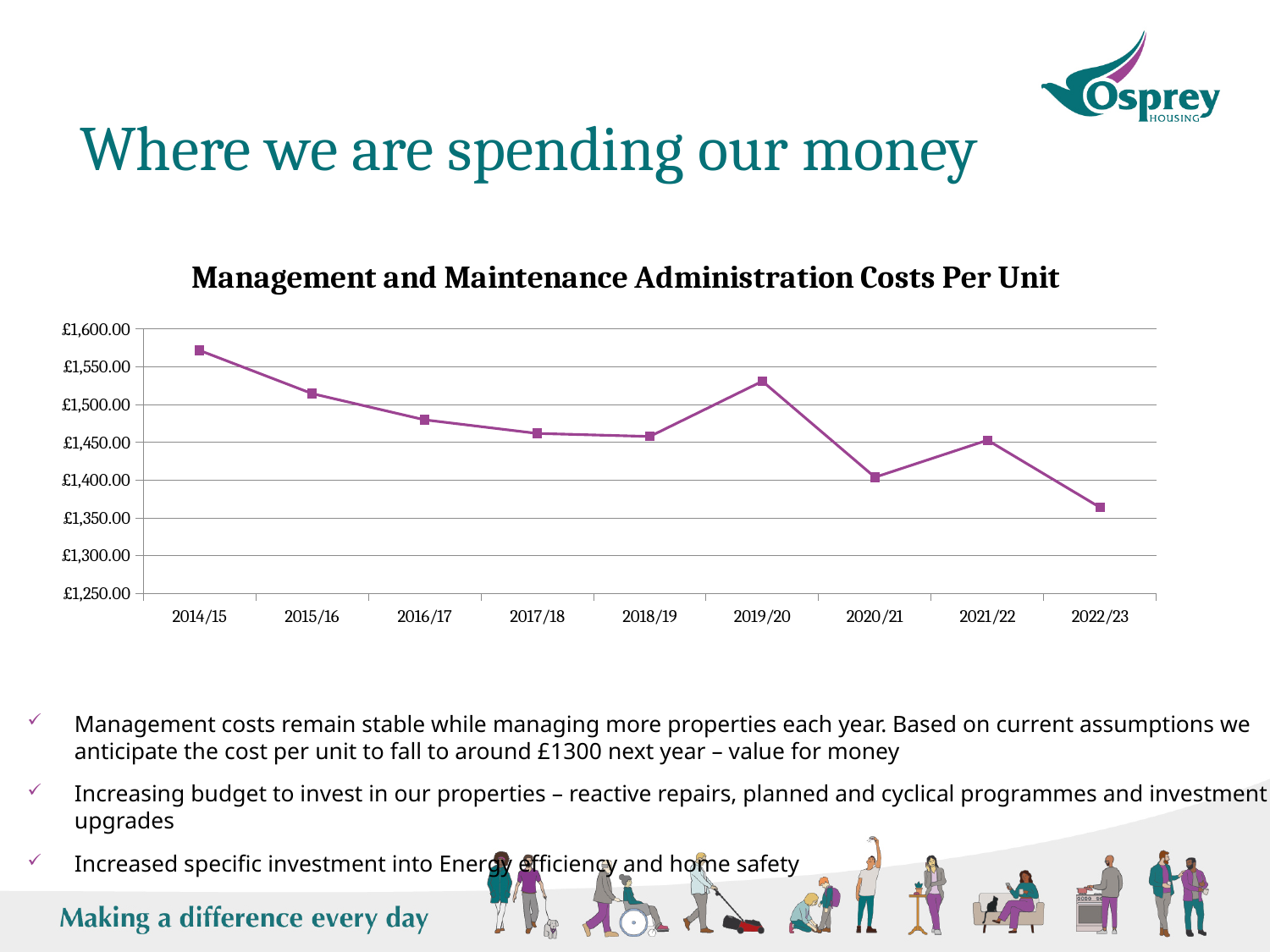
What is the title of the chart? Management and Maintenance Administration Costs Per Unit Which year has the lowest cost per unit? 2022/23 Is the value for 2022/23 greater or less than £1,400.00? less What kind of chart is shown on the slide? Line chart How many years are plotted on the x axis of the chart? 9 Which year has the higher cost per unit, 2015/16 or 2021/22? 2015/16 Is the value for 2014/15 greater or less than £1,550.00? greater Which year has the higher cost per unit, 2019/20 or 2020/21? 2019/20 Overall, does the cost per unit rise or fall from 2014/15 to 2022/23? Fall Which year has the highest cost per unit? 2014/15 Is the value for 2019/20 greater or less than £1,500.00? greater